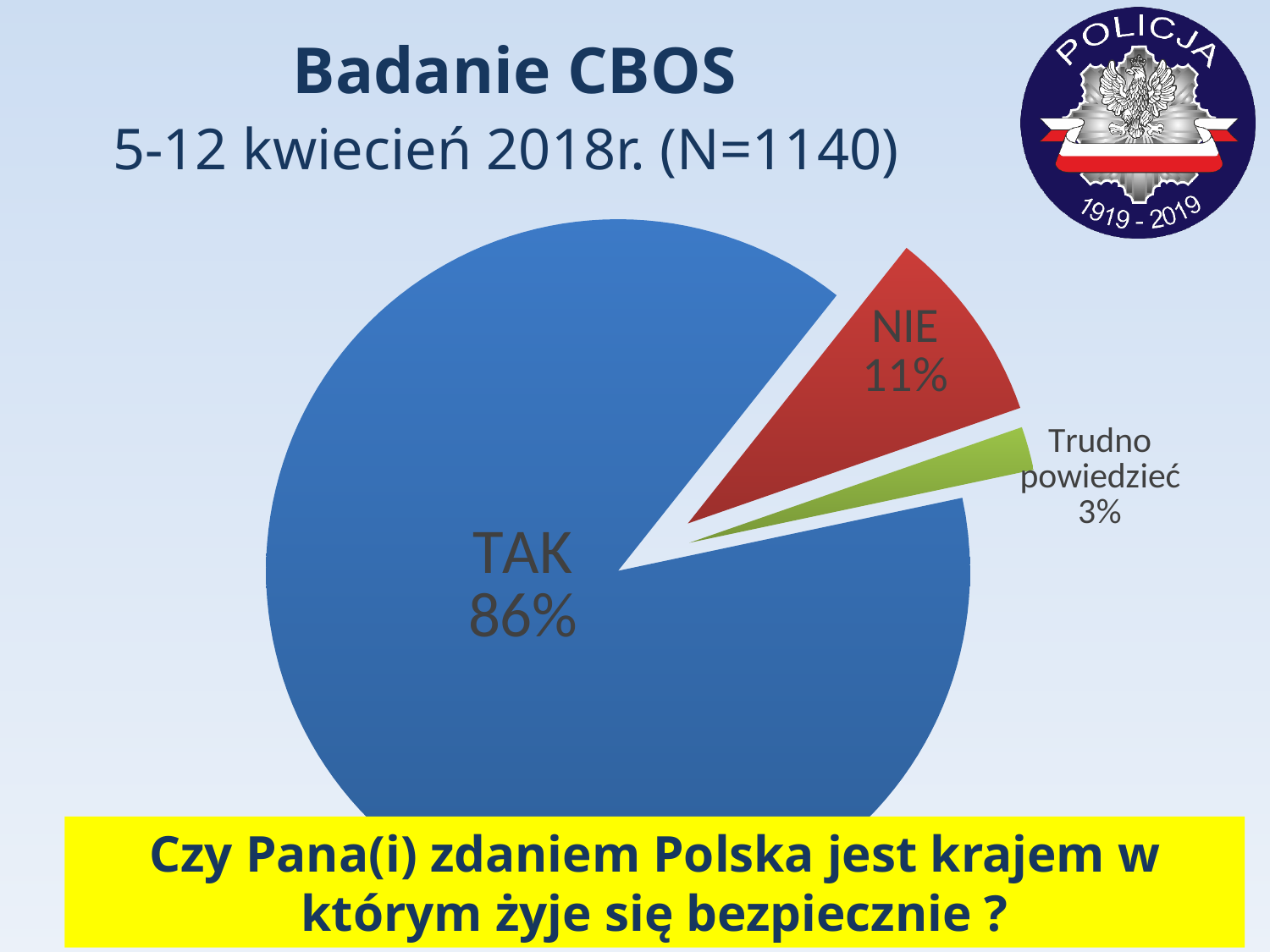
What is the difference in percentage points between NIE and Trudno powiedzieć? 8 Which answer has the largest share of the pie? TAK What colour is the TAK slice? Blue What percentage of respondents answered Trudno powiedzieć? 3% What percentage of respondents answered NIE? 11% How many slices does the pie chart have? 3 What is the difference in percentage points between TAK and NIE? 75 What percentage of respondents answered TAK? 86% What is the sample size (N) stated in the slide title? 1140 Which answer has the smallest share of the pie? Trudno powiedzieć What kind of chart is shown on the slide? Pie chart Which is larger, the share for NIE or the share for Trudno powiedzieć? NIE